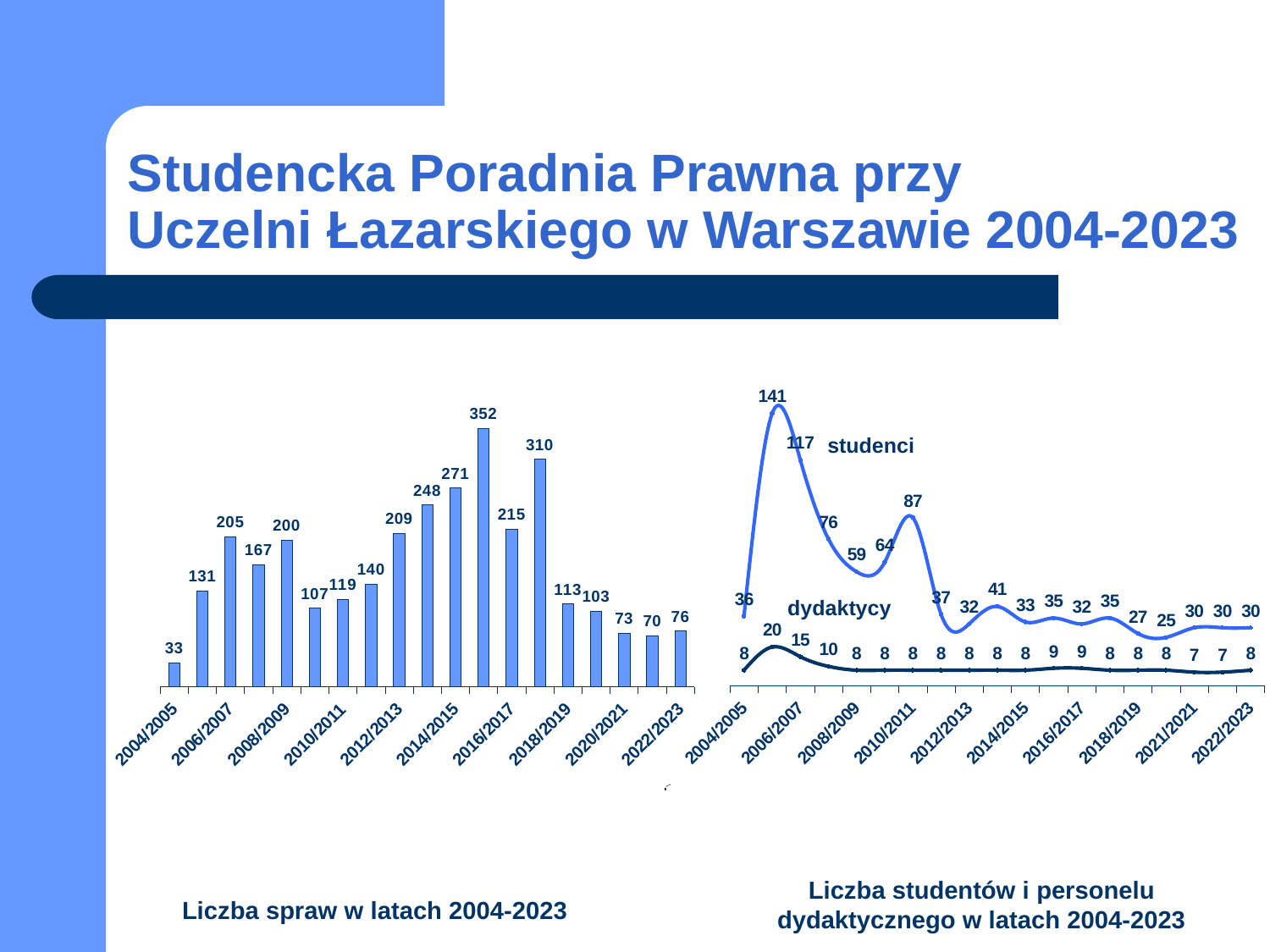
What kind of chart is the left chart, 'Liczba spraw w latach 2004-2023'? bar chart In the left chart 'Liczba spraw w latach 2004-2023', what is the lowest value shown? 33 What are the names of the two series in the right chart 'Liczba studentów i personelu dydaktycznego w latach 2004-2023'? studenci and dydaktycy In the left chart 'Liczba spraw w latach 2004-2023', what is the value for 2004/2005? 33 In the right chart 'Liczba studentów i personelu dydaktycznego w latach 2004-2023', what is the highest value of the 'studenci' series? 141 In the left chart 'Liczba spraw w latach 2004-2023', what is the difference between the highest value (352) and the value for 2004/2005 (33)? 319 How many bars are there in the left chart 'Liczba spraw w latach 2004-2023'? 19 In the right chart 'Liczba studentów i personelu dydaktycznego w latach 2004-2023', what is the highest value of the 'dydaktycy' series? 20 In the left chart 'Liczba spraw w latach 2004-2023', what is the value for 2022/2023? 76 In the left chart 'Liczba spraw w latach 2004-2023', which is larger: the value for 2006/2007 or the value for 2008/2009? 2006/2007 In the left chart 'Liczba spraw w latach 2004-2023', what is the highest value shown? 352 How many series are plotted in the right chart 'Liczba studentów i personelu dydaktycznego w latach 2004-2023'? 2